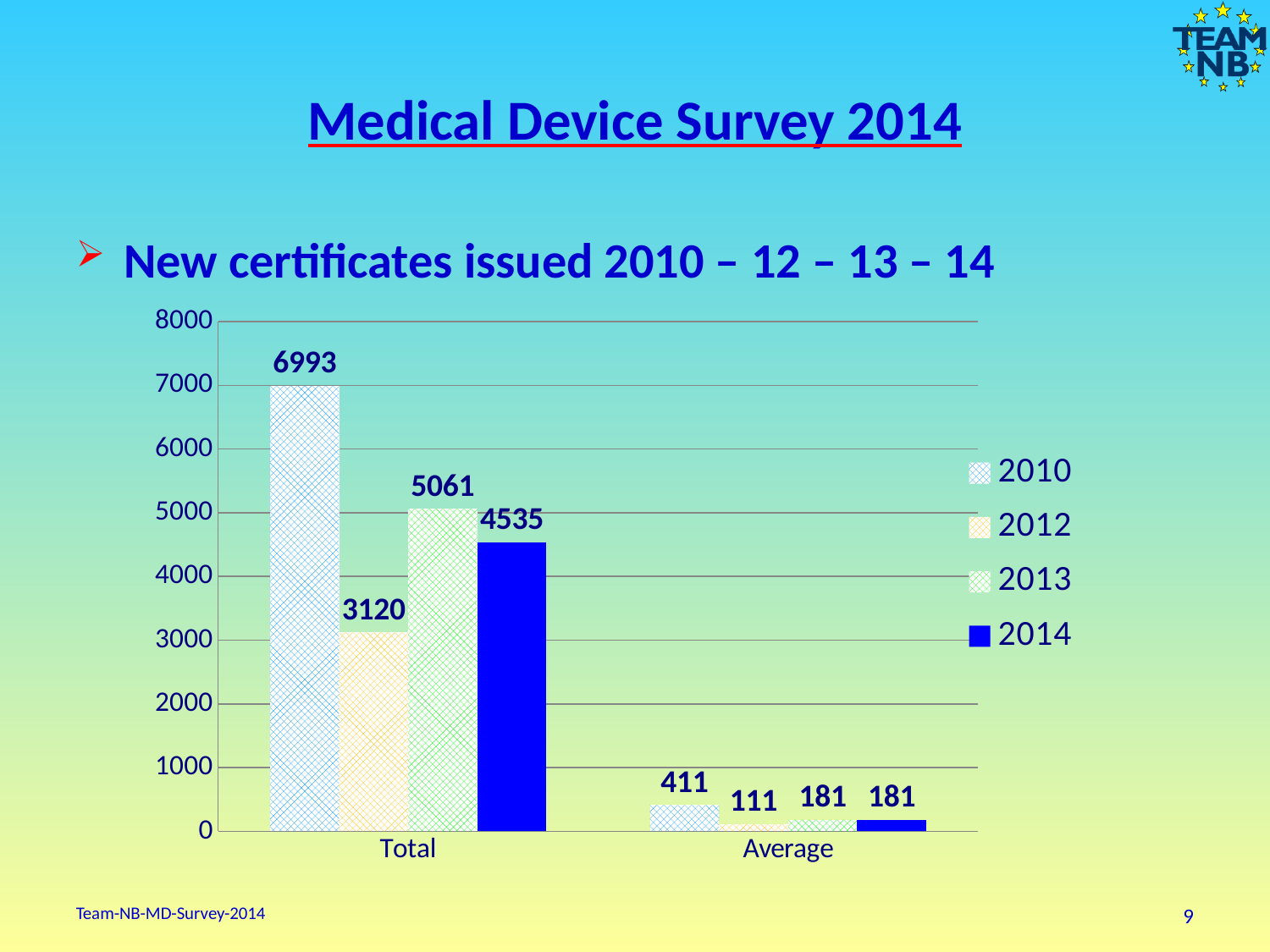
What kind of chart is shown on the slide? Bar chart How many categories are shown on the x axis? 2 How many series does the legend list? 4 What is the Total value for 2012? 3120 What is the difference between the Total values for 2013 and 2014? 526 Which is larger, the Total value for 2013 or the Total value for 2014? 2013 Which year has the lowest Average value? 2012 Which year has the highest Total value? 2010 What is the Average value for 2014? 181 What is the Total value for 2010? 6993 What is the Average value for 2010? 411 What is the difference between the Total values for 2010 and 2012? 3873